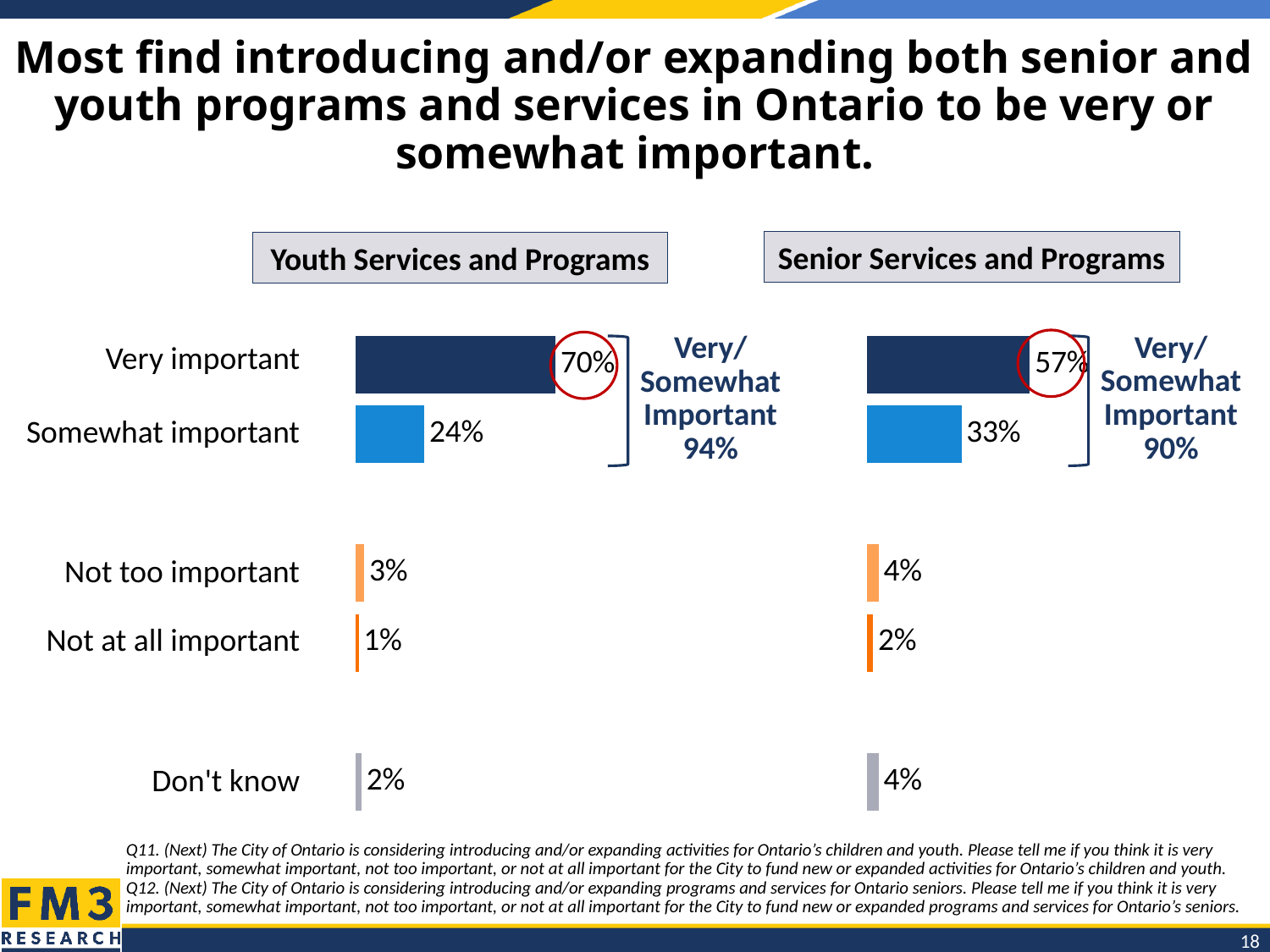
Which chart has the larger value for 'Very important', Youth Services and Programs or Senior Services and Programs? Youth Services and Programs In the Youth Services and Programs chart, what is the difference between 'Not too important' and 'Not at all important'? 2% What type of chart is used for Senior Services and Programs? Bar chart In the Youth Services and Programs chart, which category has the highest value? Very important In the Youth Services and Programs chart, which category has the lowest value? Not at all important How many categories are shown in the Youth Services and Programs chart? 5 In the Youth Services and Programs chart, what percentage said 'Very important'? 70% In the Senior Services and Programs chart, what percentage said 'Somewhat important'? 33% In the Senior Services and Programs chart, what is the combined Very/Somewhat Important percentage shown? 90% In the Youth Services and Programs chart, what is the combined Very/Somewhat Important percentage shown? 94% In the Senior Services and Programs chart, what is the difference between 'Very important' and 'Somewhat important'? 24% In the Senior Services and Programs chart, what percentage said 'Don't know'? 4%